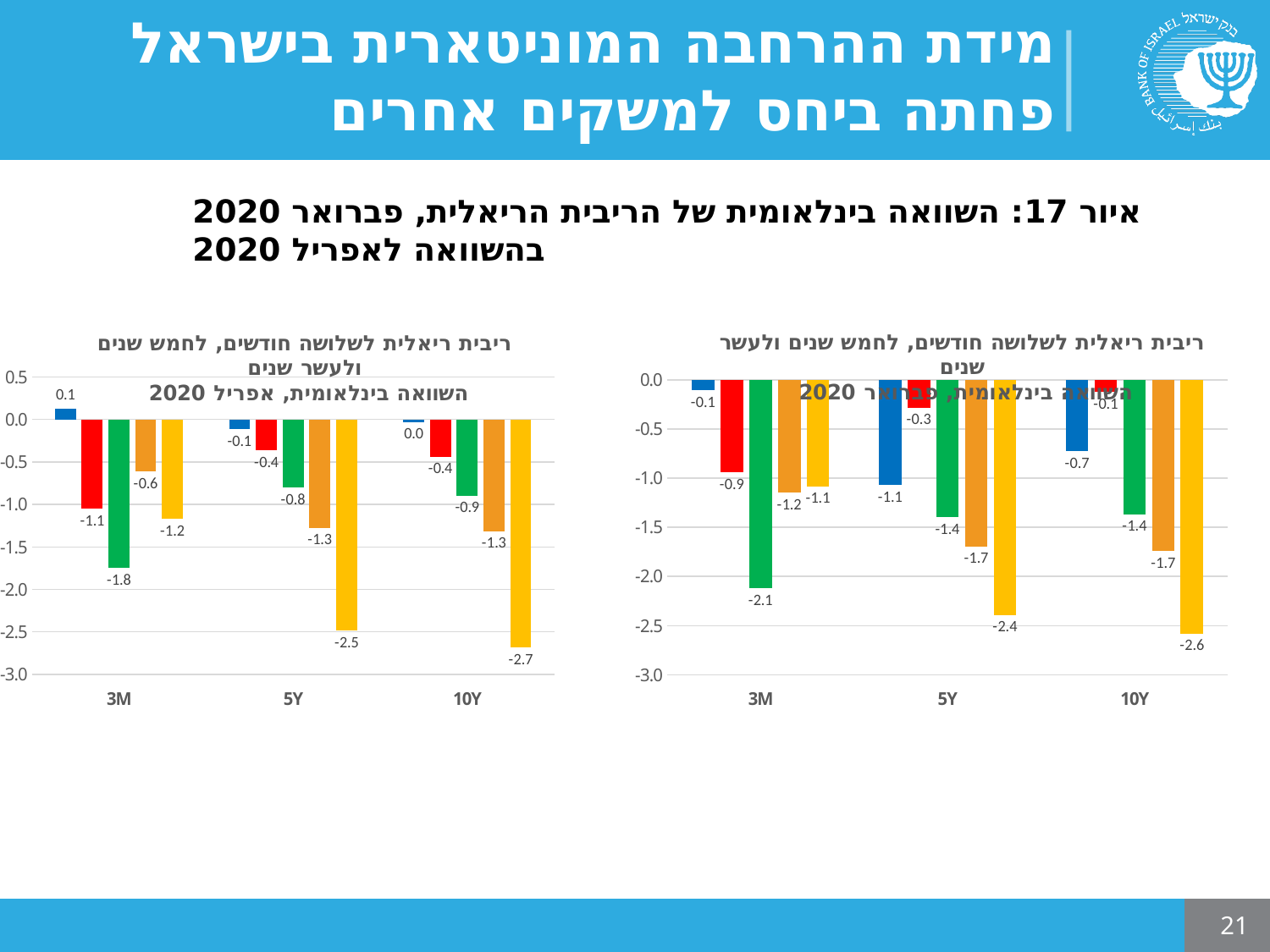
In the left chart (April 2020), what is the value of the blue bar for 3M? 0.1 In the right chart (February 2020), what is the value of the orange bar for 5Y? -1.7 In the right chart (February 2020), what is the value of the green bar for 3M? -2.1 In the right chart (February 2020), which is larger: the blue bar for 5Y or the blue bar for 10Y? the blue bar for 10Y (-0.7) What type of chart is the right chart (February 2020)? bar chart In the left chart (April 2020), what is the value of the yellow bar for 10Y? -2.7 In the left chart (April 2020), which bar in the 5Y group has the lowest value? the yellow bar (-2.5) In the left chart (April 2020), what is the difference between the yellow bar for 10Y (-2.7) and the yellow bar for 5Y (-2.5)? 0.2 In the right chart (February 2020), which bar in the 10Y group has the highest value? the red bar (-0.1) How many categories are shown on the x axis of the left chart (April 2020)? 3 In the right chart (February 2020), is the value of the yellow bar for 5Y greater or less than -2.0? less How many bars are shown in each category group of the left chart (April 2020)? 5